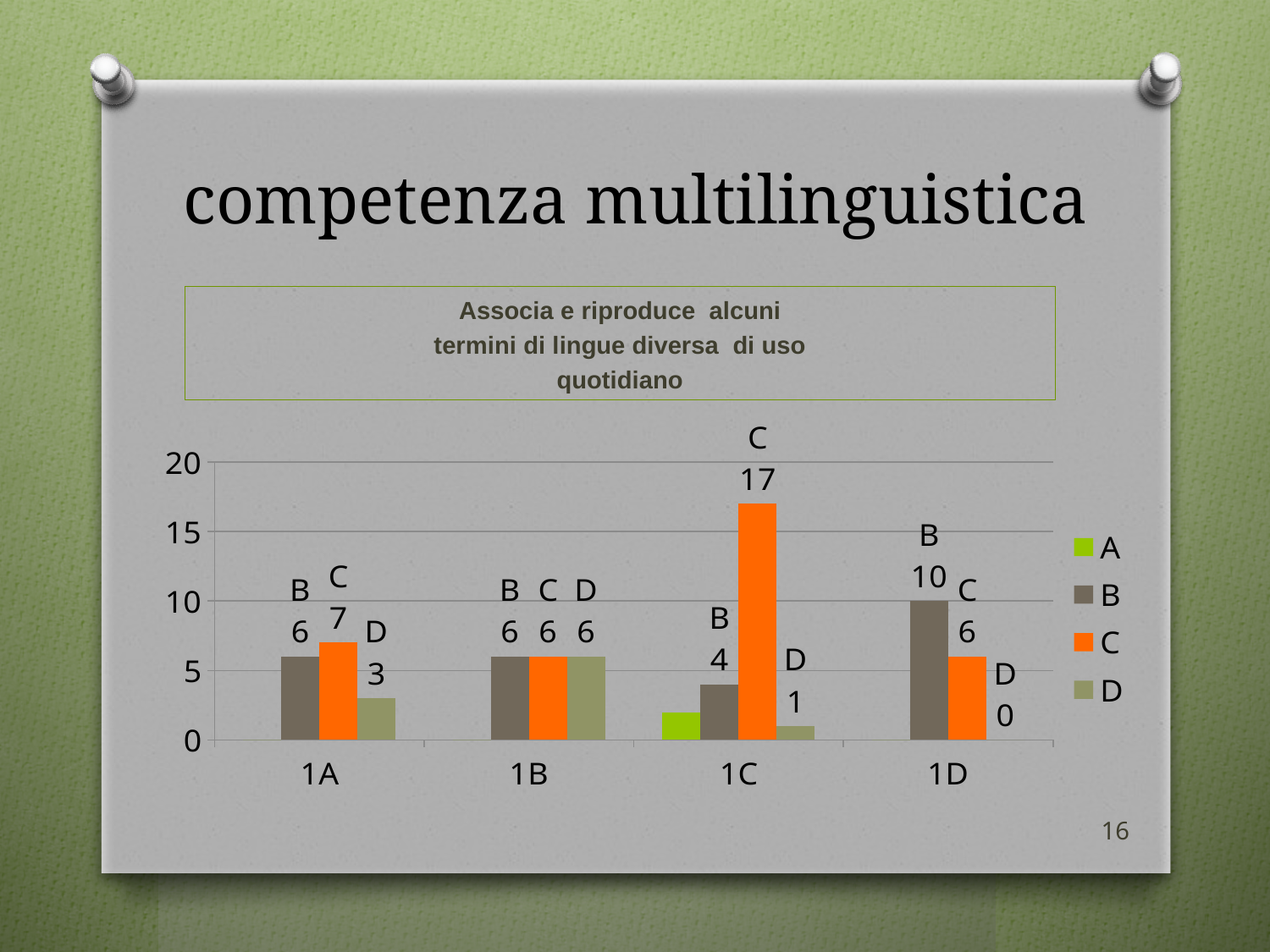
Is the value of series A for category 1C greater or less than 5? less Which category has the highest value for series C? 1C What kind of chart is shown on the slide? bar chart How many categories are shown on the x axis? 4 Which is larger: series C for 1A or series C for 1B? series C for 1A What is the value of series D for category 1A? 3 What is the difference between the value of series C for 1C and the value of series B for 1D? 7 What is the value of series D for category 1D? 0 What is the value of series C for category 1C? 17 What is the value of series B for category 1D? 10 Which category has the lowest value for series D? 1D How many series does the legend list? 4